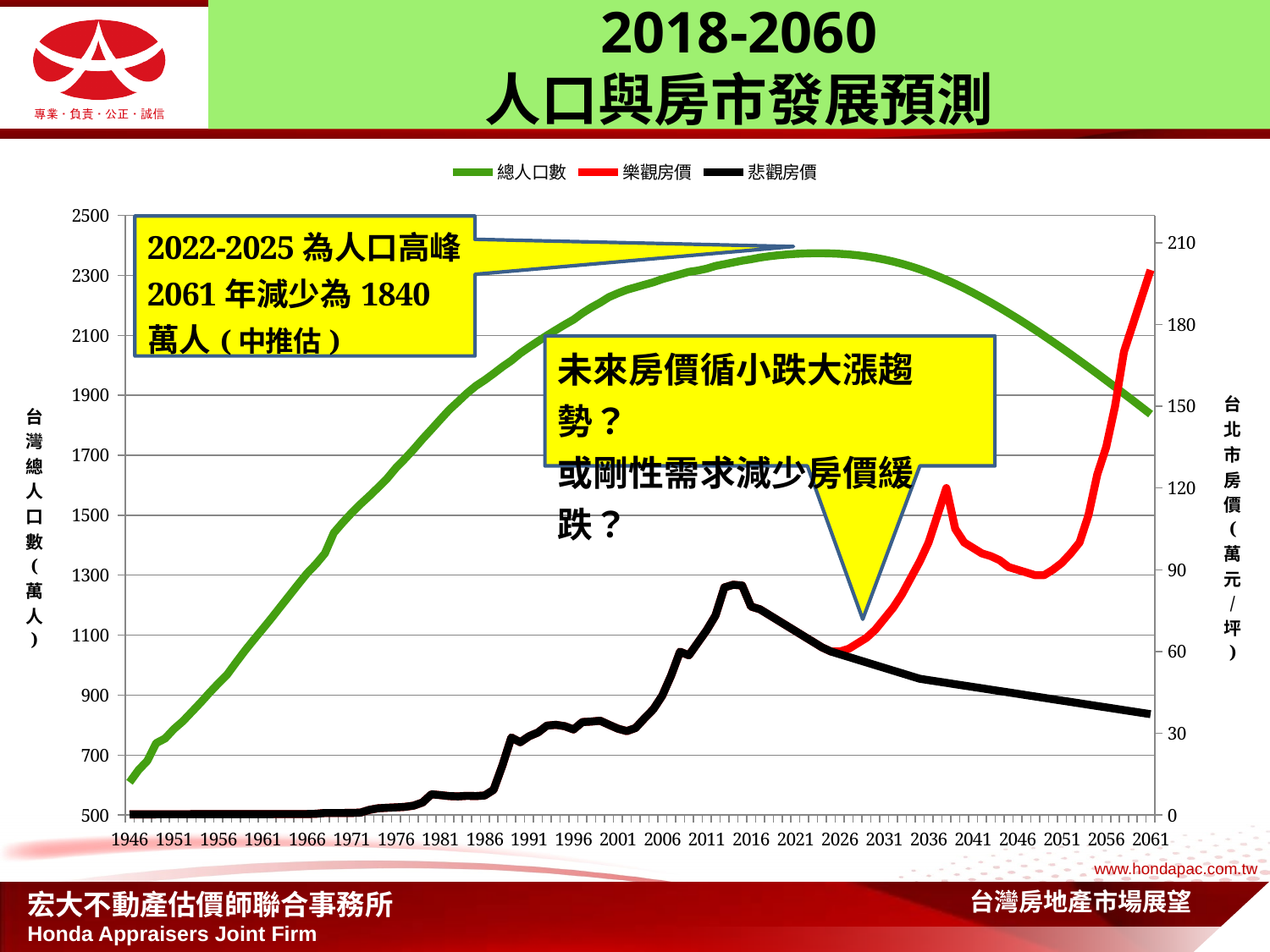
Is the value of 悲觀房價 in 2061 greater or less than 60? less Does 總人口數 rise or fall from 1946 to 2021? rise What is the title of the slide containing the chart? 2018-2060 人口與房市發展預測 What are the three series named in the legend? 總人口數, 樂觀房價, 悲觀房價 Is the value of 樂觀房價 in 2061 greater or less than 180? greater In 2061, which is larger, 樂觀房價 or 悲觀房價? 樂觀房價 Is the value of 總人口數 in 1946 greater or less than 700? less Does 悲觀房價 rise or fall from 2016 to 2061? fall What kind of chart is shown on the slide? line chart How many series does the legend list? 3